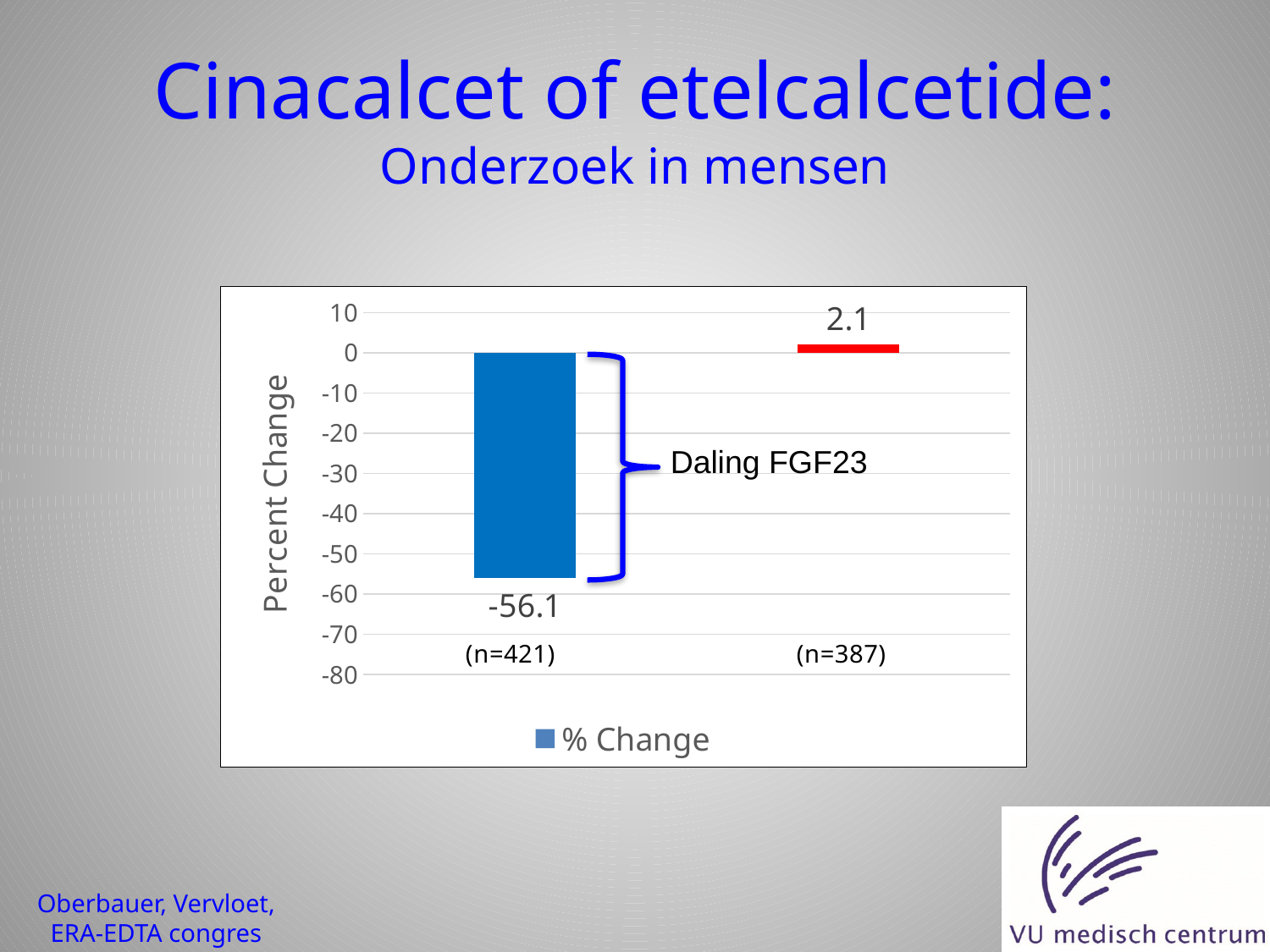
How many bars are plotted in the chart? 2 What is the value of the bar labelled (n=387)? 2.1 Is the value for (n=421) greater or less than -50? less Which bar has the highest value, (n=421) or (n=387)? (n=387) What type of chart is shown on the slide? bar chart What is the legend entry of the chart? % Change What is the value of the bar labelled (n=421)? -56.1 Is the value for (n=387) greater or less than 0? greater How many series does the legend list? 1 What is the label of the vertical axis? Percent Change What is the difference between the values for (n=387) and (n=421)? 58.2 Which bar has the lowest value, (n=421) or (n=387)? (n=421)